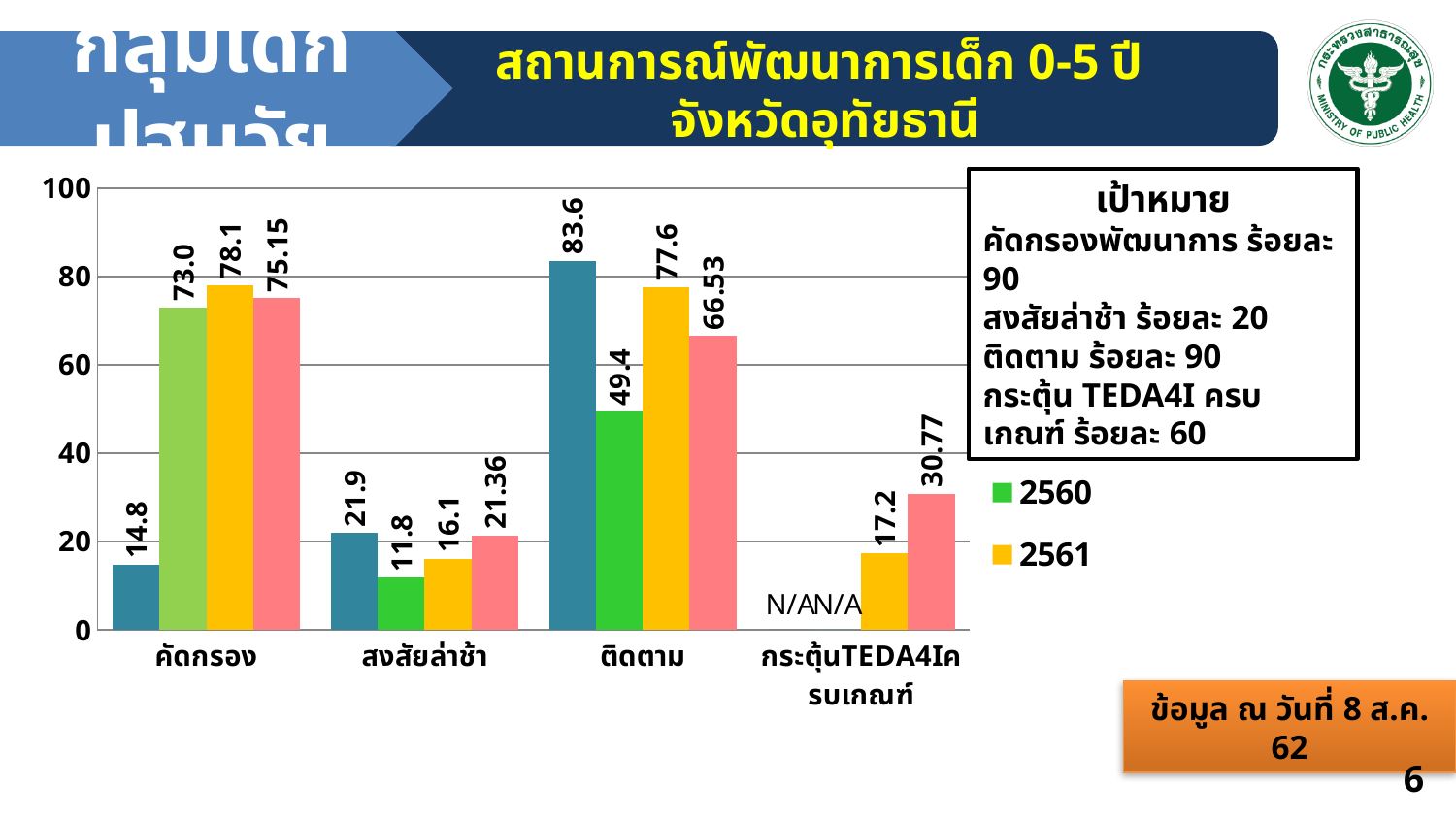
How many categories are shown on the x axis of the chart? 4 What is the value for 2561 in the คัดกรอง category? 78.1 What is the value for 2560 in the สงสัยล่าช้า category? 11.8 What is the value for 2560 in the ติดตาม category? 49.4 What is shown in place of the 2560 value in the กระตุ้นTEDA4Iครบเกณฑ์ category? N/A Is the 2561 value for ติดตาม greater or less than 60? greater What is the value for 2561 in the กระตุ้นTEDA4Iครบเกณฑ์ category? 17.2 What kind of chart is shown on the slide? bar chart What is the difference between the 2561 and 2560 values in the ติดตาม category? 28.2 What is the difference between the 2561 and 2560 values in the คัดกรอง category? 5.1 Which category has the highest value for the 2561 series? คัดกรอง In the สงสัยล่าช้า category, which is larger, the 2560 value or the 2561 value? 2561